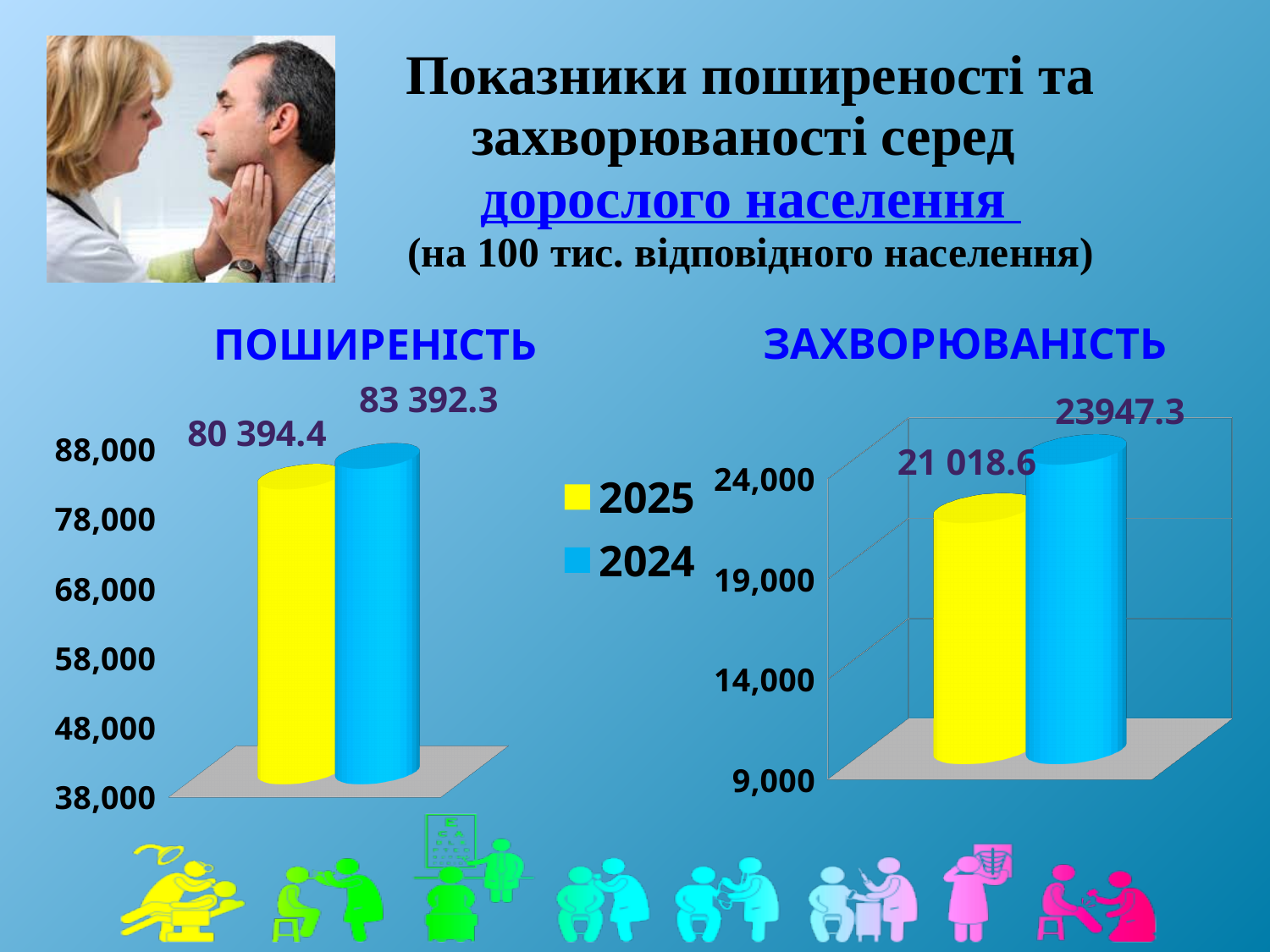
In the ПОШИРЕНІСТЬ chart, what is the value for 2025? 80 394.4 In the ЗАХВОРЮВАНІСТЬ chart, what is the value for 2024? 23947.3 In the ПОШИРЕНІСТЬ chart, which year has the higher value? 2024 In the ПОШИРЕНІСТЬ chart, what is the difference between the 2024 and 2025 values? 2 997.9 In the ЗАХВОРЮВАНІСТЬ chart, which year has the lower value? 2025 In the ЗАХВОРЮВАНІСТЬ chart, what is the value for 2025? 21 018.6 In the ПОШИРЕНІСТЬ chart, what is the value for 2024? 83 392.3 How many series does the legend list? 2 What kind of chart is the ПОШИРЕНІСТЬ chart? bar chart Which colour represents 2025 in the legend? yellow In the ЗАХВОРЮВАНІСТЬ chart, what is the difference between the 2024 and 2025 values? 2928.7 In the ЗАХВОРЮВАНІСТЬ chart, is the value for 2025 greater or less than 24,000? less